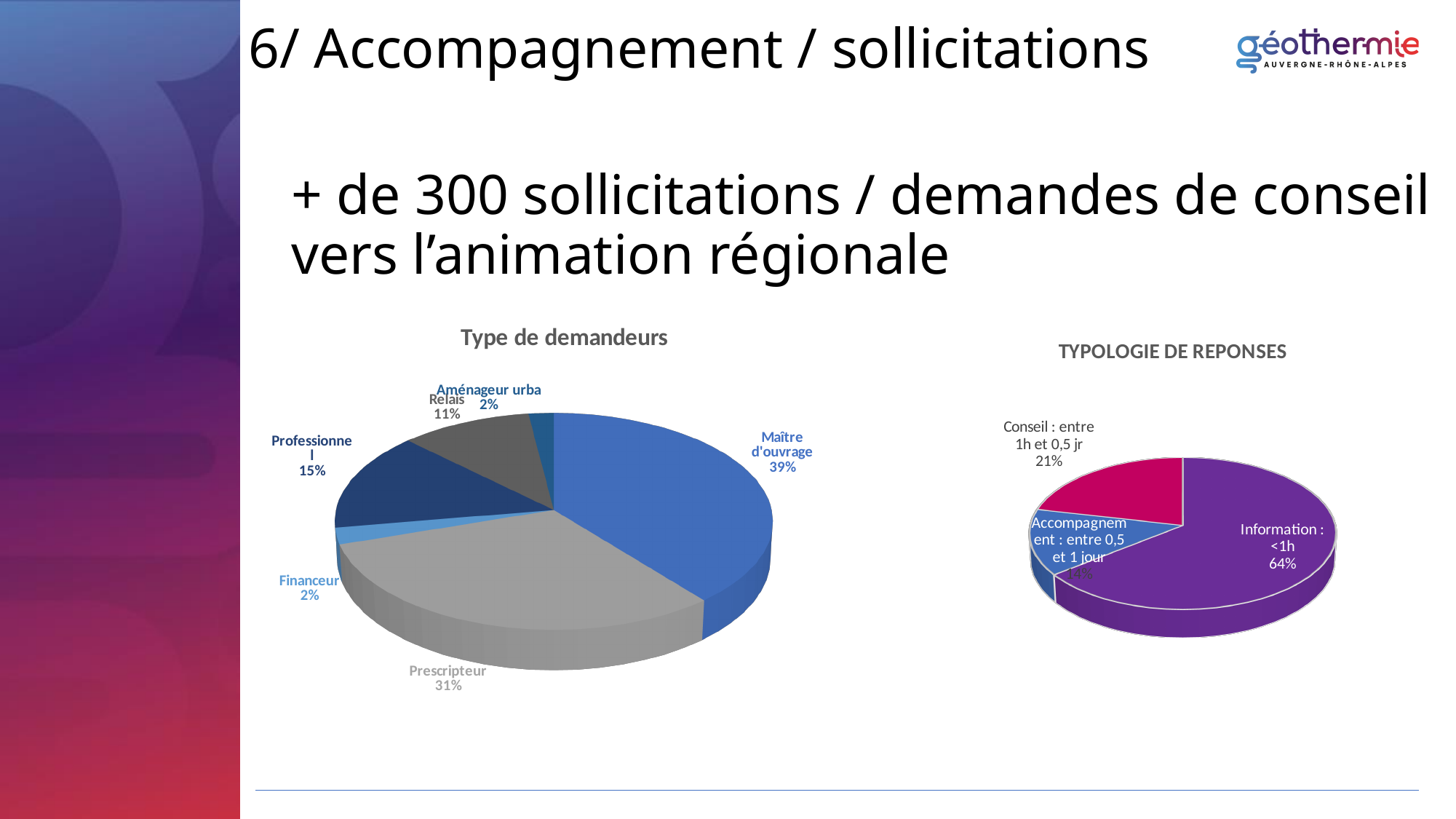
In the 'Type de demandeurs' chart, what share is Professionnel? 15% In the 'Type de demandeurs' chart, which is larger, Professionnel or Relais? Professionnel In the 'TYPOLOGIE DE REPONSES' chart, which category has the smallest share? Accompagnement : entre 0,5 et 1 jour What kind of chart is 'TYPOLOGIE DE REPONSES'? Pie chart In the 'Type de demandeurs' chart, what share is Prescripteur? 31% In the 'Type de demandeurs' chart, what is the difference between the Maître d'ouvrage and Prescripteur shares? 8 percentage points In the 'TYPOLOGIE DE REPONSES' chart, what share is 'Conseil : entre 1h et 0,5 jr'? 21% In the 'TYPOLOGIE DE REPONSES' chart, what share is 'Information : <1h'? 64% In the 'Type de demandeurs' chart, what share is Relais? 11% In the 'Type de demandeurs' chart, what share is Maître d'ouvrage? 39% In the 'Type de demandeurs' chart, which category has the largest share? Maître d'ouvrage In the 'Type de demandeurs' chart, how many categories are shown? 6